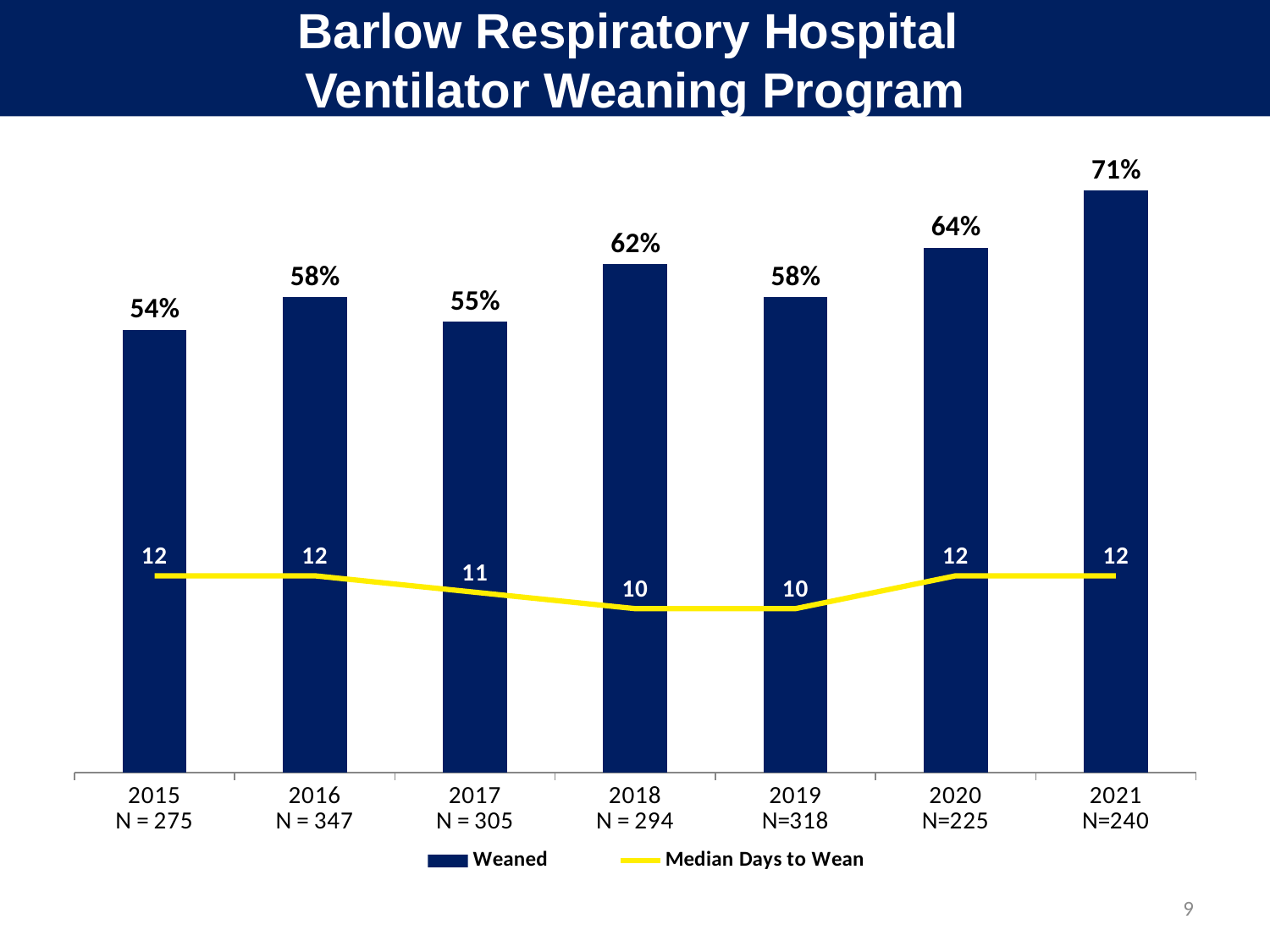
How many series does the legend list? 2 What is the Weaned percentage for 2021? 71% How many years are shown on the x axis? 7 What is the Median Days to Wean value for 2017? 11 What is the difference in Weaned percentage between 2021 and 2015? 17% What kind of chart is used to show the Weaned series? Bar chart What is the Weaned percentage for 2015? 54% Which year has the highest Weaned percentage? 2021 What is the Median Days to Wean value for 2018? 10 Which year has the lowest Weaned percentage? 2015 Which year has a higher Weaned percentage, 2018 or 2019? 2018 What is the N value shown for 2016? N = 347